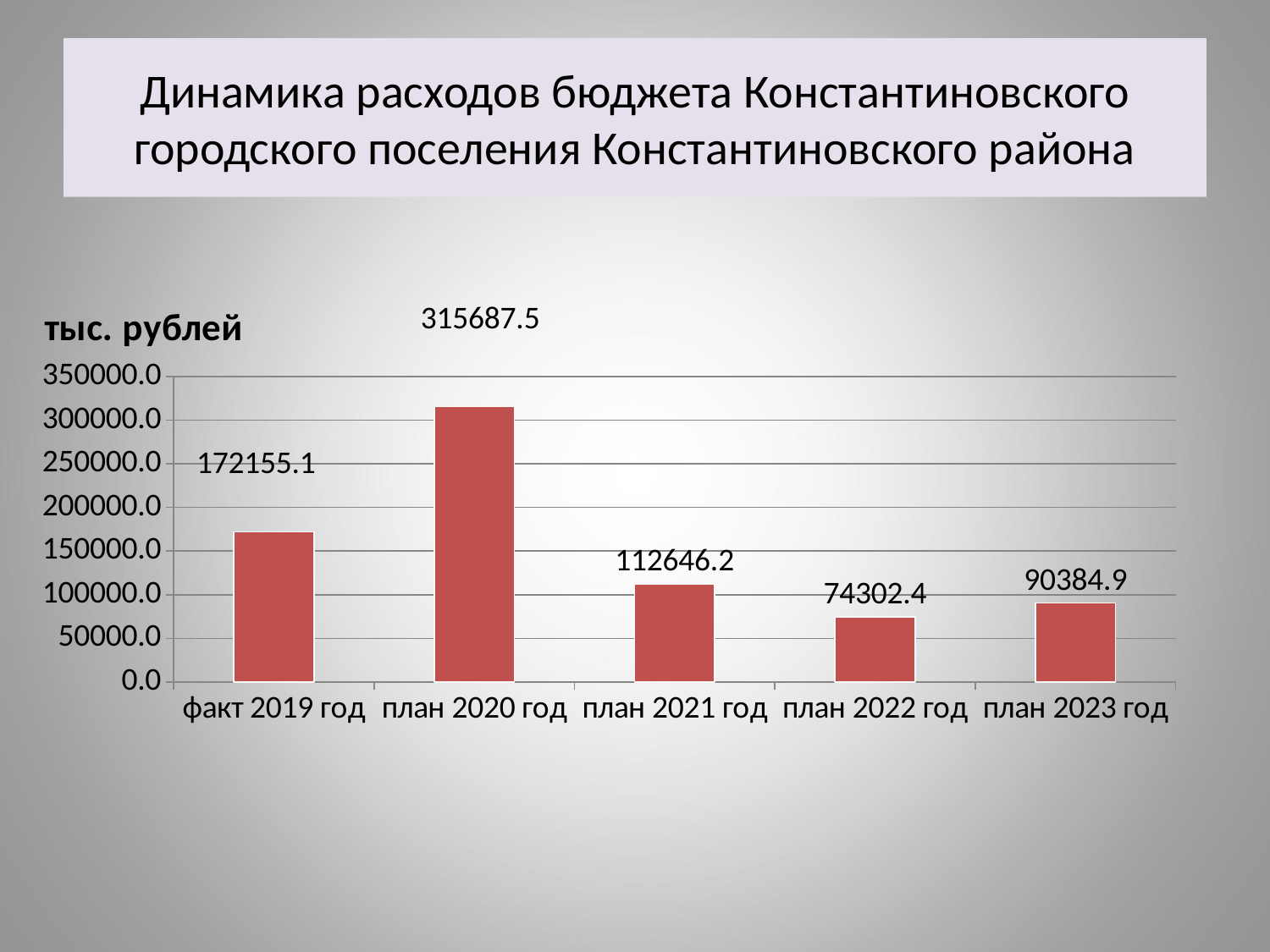
What kind of chart is shown on the slide? bar chart What is the value for план 2023 год? 90384.9 What is the difference between the values for план 2020 год and факт 2019 год? 143532.4 Is the value for план 2020 год greater or less than 300000.0? greater How many categories are shown on the x axis? 5 Do the values rise or fall from план 2020 год to план 2022 год? fall Which category has the highest value? план 2020 год Which category has the lowest value? план 2022 год What is the value for факт 2019 год? 172155.1 What is the value for план 2021 год? 112646.2 Which is larger, the value for план 2021 год or план 2023 год? план 2021 год What is the difference between the values for план 2023 год and план 2022 год? 16082.5